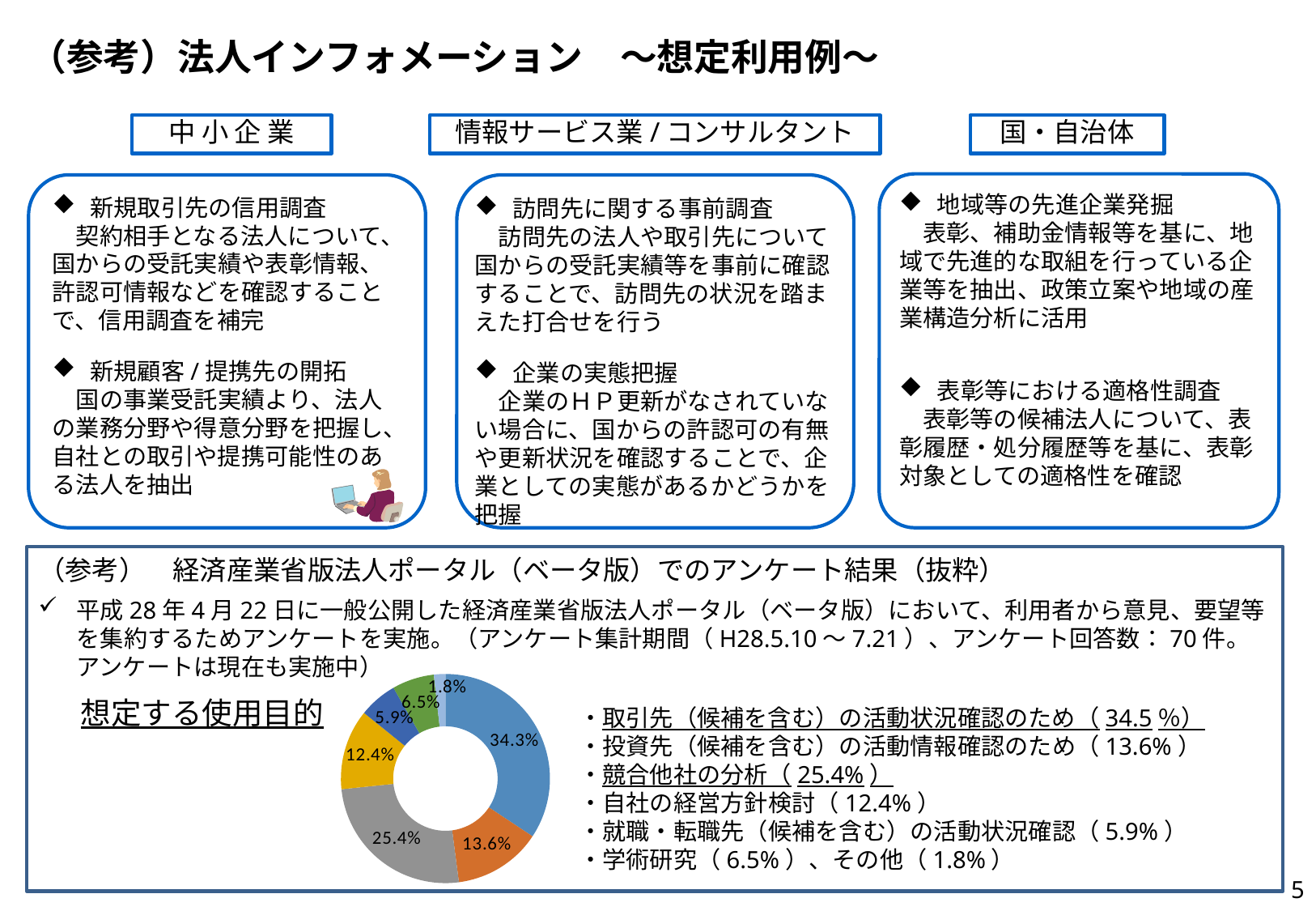
What is the difference in percentage points between the 25.4% slice and the 13.6% slice? 11.8 What share of responses is shown for 投資先（候補を含む）の活動情報確認のため? 13.6% What is the combined share of 学術研究 and その他? 8.3% What share of responses is shown for 自社の経営方針検討? 12.4% What is the heading written to the left of the doughnut chart? 想定する使用目的 What is the value printed on the smallest slice of the doughnut chart? 1.8% Which is larger, the slice for 競合他社の分析 or the slice for 投資先（候補を含む）の活動情報確認のため? 競合他社の分析 What share of responses is shown for 学術研究? 6.5% How many slices does the doughnut chart have? 7 What kind of chart is shown on the slide? Pie (doughnut) chart What is the value printed on the largest slice of the doughnut chart? 34.3% What share of responses is shown for 競合他社の分析? 25.4%